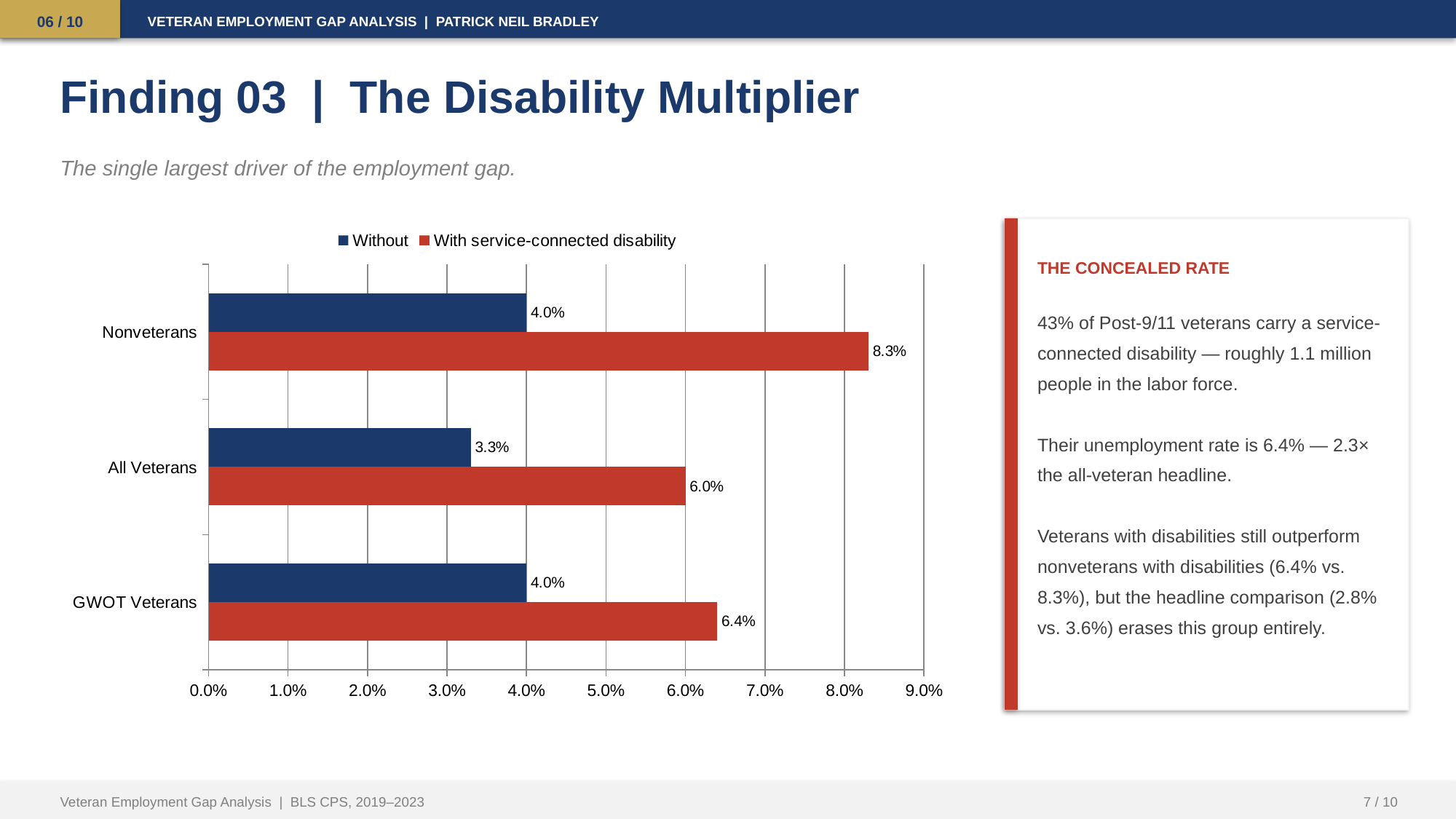
What is the difference between the 'With service-connected disability' values for Nonveterans and GWOT Veterans? 1.9% Which category has the lowest value in the 'Without' series? All Veterans How many series does the legend list? 2 What kind of chart is shown on the slide? Bar chart What is the difference between the 'With service-connected disability' and 'Without' values for Nonveterans? 4.3% What is the value for Nonveterans in the 'With service-connected disability' series? 8.3% What is the value for GWOT Veterans in the 'With service-connected disability' series? 6.4% What is the value for All Veterans in the 'Without' series? 3.3% How many categories are shown on the chart? 3 Which is larger: the 'With service-connected disability' value for All Veterans or for GWOT Veterans? GWOT Veterans Which category has the highest value in the 'With service-connected disability' series? Nonveterans What colour are the bars for the 'With service-connected disability' series? Red